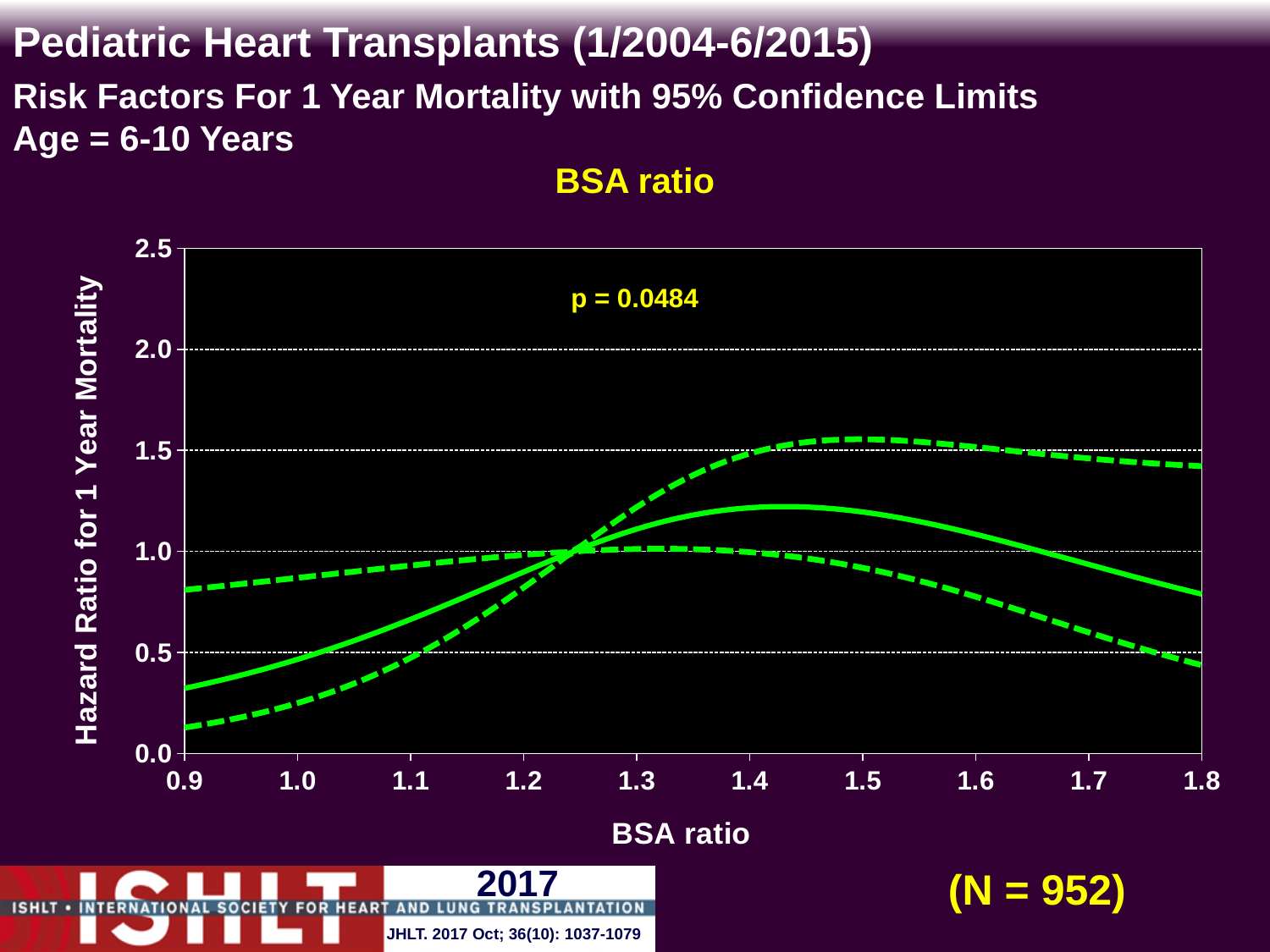
Is the upper confidence limit (upper dashed line) at a BSA ratio of 1.5 greater or less than 1.0? greater Is the hazard ratio (solid line) at a BSA ratio of 1.4 greater or less than 1.0? greater How many lines are plotted on the chart? 3 Does the hazard ratio (solid line) rise or fall as the BSA ratio increases from 0.9 to 1.4? rise Is the lower confidence limit (lower dashed line) at a BSA ratio of 1.8 greater or less than 1.0? less Does the hazard ratio (solid line) rise or fall as the BSA ratio increases from 1.5 to 1.8? fall How many tick labels are shown on the x axis? 10 What is the sample size (N) shown on the slide? 952 What is the p-value printed on the chart? p = 0.0484 What kind of chart is shown on the slide? line chart